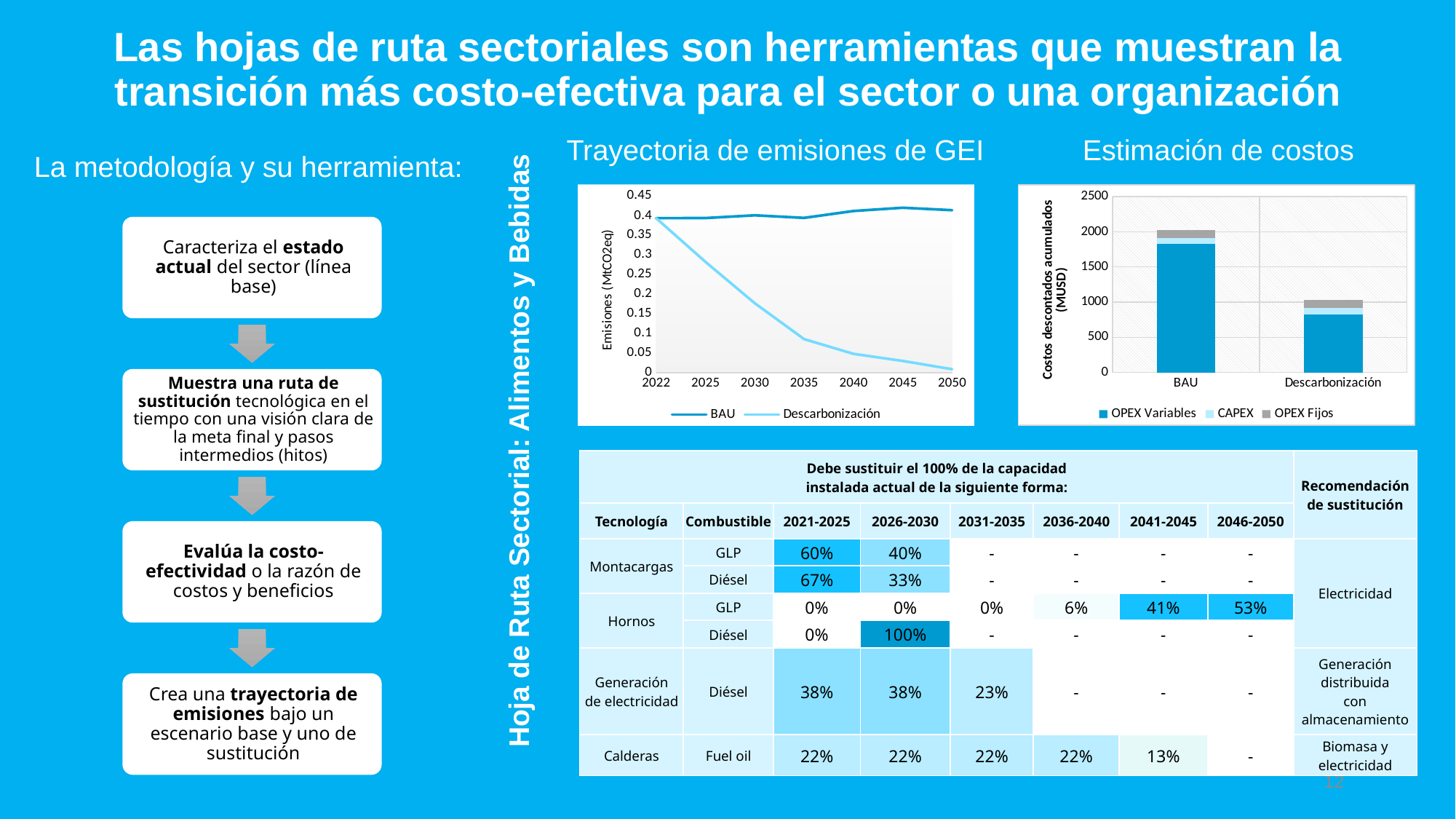
In the 'Trayectoria de emisiones de GEI' chart, is the value for BAU in 2022 greater or less than 0.35? greater In the 'Trayectoria de emisiones de GEI' chart, do the values for Descarbonización rise or fall from 2022 to 2050? fall In the 'Estimación de costos' chart, what is the label of the y axis? Costos descontados acumulados (MUSD) In the 'Trayectoria de emisiones de GEI' chart, which series has the higher value in 2050, BAU or Descarbonización? BAU In the 'Trayectoria de emisiones de GEI' chart, is the value for Descarbonización in 2030 greater or less than 0.2? less In the 'Estimación de costos' chart, how many series does the legend list? 3 What kind of chart is the 'Trayectoria de emisiones de GEI' chart? line chart In the 'Estimación de costos' chart, how many categories are shown on the x axis? 2 In the 'Estimación de costos' chart, is the OPEX Variables value for BAU greater or less than 1500? greater What kind of chart is the 'Estimación de costos' chart? bar chart In the 'Trayectoria de emisiones de GEI' chart, how many series does the legend list? 2 In the 'Estimación de costos' chart, which category has the taller total bar, BAU or Descarbonización? BAU